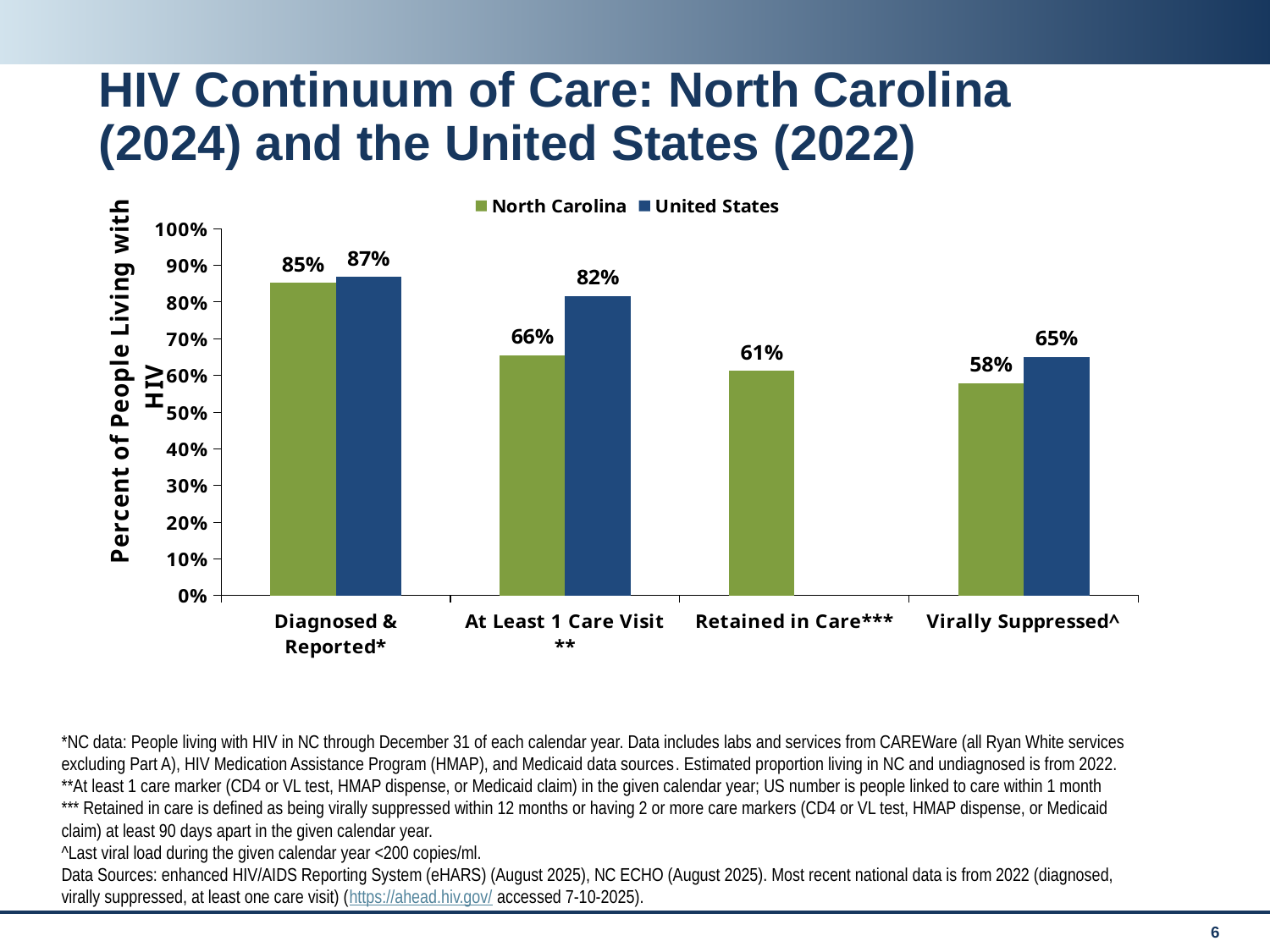
What is the North Carolina value for Virally Suppressed^? 58% Which category has the lowest North Carolina value? Virally Suppressed^ What kind of chart is shown on the slide? Bar chart Is the North Carolina value for At Least 1 Care Visit** greater or less than 70%? less What is the United States value for At Least 1 Care Visit**? 82% Which category has the highest North Carolina value? Diagnosed & Reported* What is the North Carolina value for Retained in Care***? 61% What is the North Carolina value for Diagnosed & Reported*? 85% Which is larger for Virally Suppressed^: North Carolina or United States? United States How many series does the legend list? 2 How many categories are shown on the x axis? 4 What is the difference between the United States and North Carolina values for At Least 1 Care Visit**? 16%